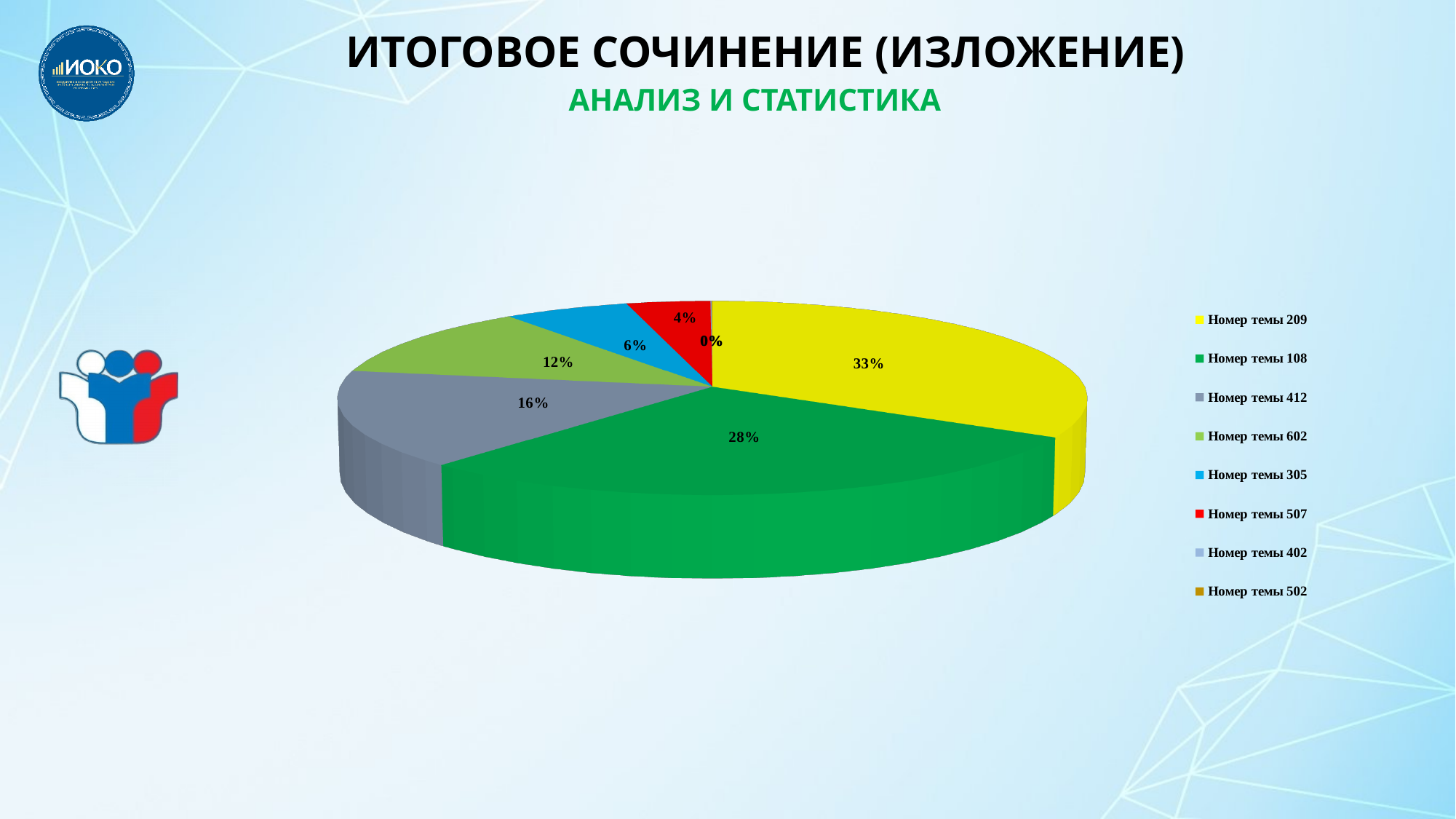
What colour is the slice for Номер темы 209? Yellow What is the value shown for Номер темы 412? 16% What is the difference between the shares of Номер темы 209 and Номер темы 108? 5% How many entries does the legend list? 8 What is the value shown for Номер темы 507? 4% What is the value shown for Номер темы 108? 28% What share of the pie does Номер темы 209 have? 33% Which is larger, the slice for Номер темы 412 or the slice for Номер темы 602? Номер темы 412 What kind of chart is shown on the slide? Pie chart What share of the pie does Номер темы 602 have? 12% What is the value shown for Номер темы 305? 6% Which topic has the largest slice of the pie? Номер темы 209